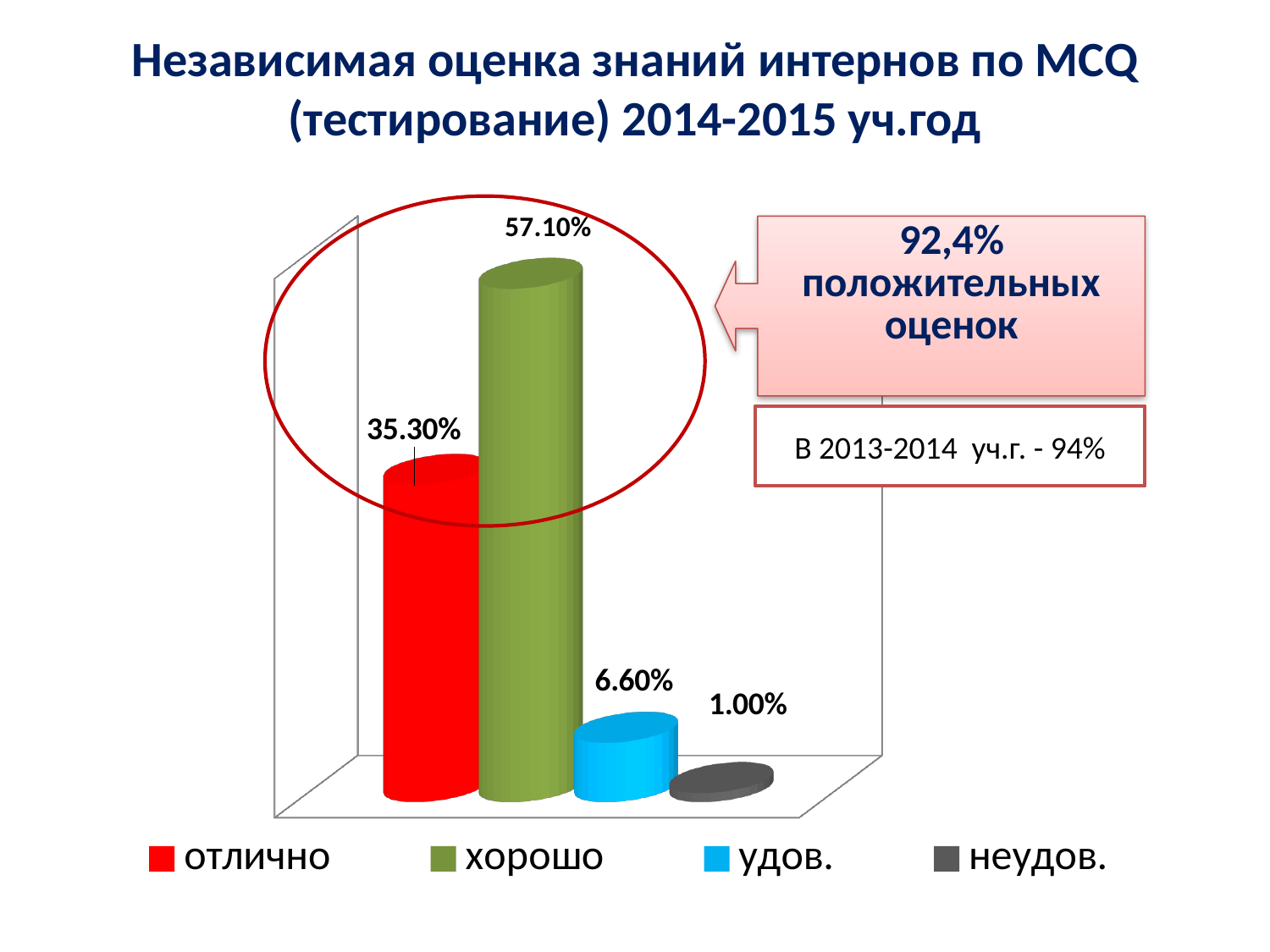
What colour is the bar for хорошо? green What kind of chart is shown on the slide? bar chart What is the value for хорошо? 57.10% What is the value for неудов.? 1.00% What is the difference between the values for хорошо and отлично? 21.80% What is the value for отлично? 35.30% Which is larger, the value for отлично or the value for удов.? отлично Which category has the highest value? хорошо How many categories does the legend list? 4 Which category has the lowest value? неудов. What is the value for удов.? 6.60% What is the total of the values for отлично and хорошо? 92.40%